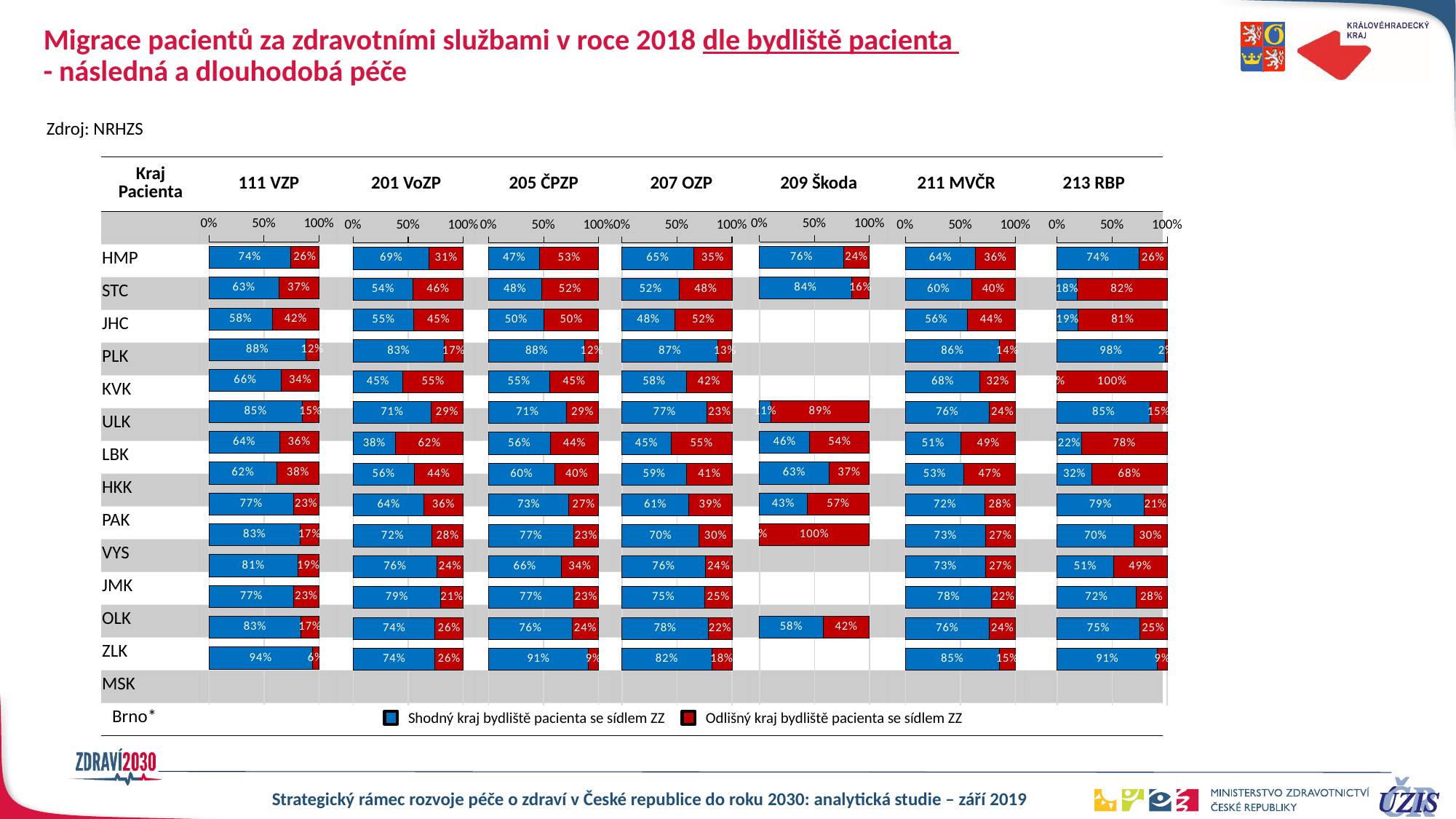
How many insurer charts (columns) are shown on the slide? 7 In the 111 VZP chart, what percentage is shown for the blue segment of the HMP bar? 74% For the HMP row, which chart shows a larger blue segment: 111 VZP or 205 ČPZP? 111 VZP What type of chart is used on this slide? Bar chart What does the blue colour represent according to the legend? Shodný kraj bydliště pacienta se sídlem ZZ For the HMP row, what is the difference in percentage points between the blue segment in the 209 Škoda chart and the blue segment in the 211 MVČR chart? 12 percentage points In the 213 RBP chart, what percentage is shown for the red segment of the STC bar? 82% For the STC row, which insurer chart shows the lowest blue segment? 213 RBP In the 209 Škoda chart, what percentage is shown for the blue segment of the STC bar? 84% How many series does the legend list? 2 For the STC row, which insurer chart shows the highest blue segment? 209 Škoda In the 205 ČPZP chart, what percentage is shown for the red segment of the HMP bar? 53%